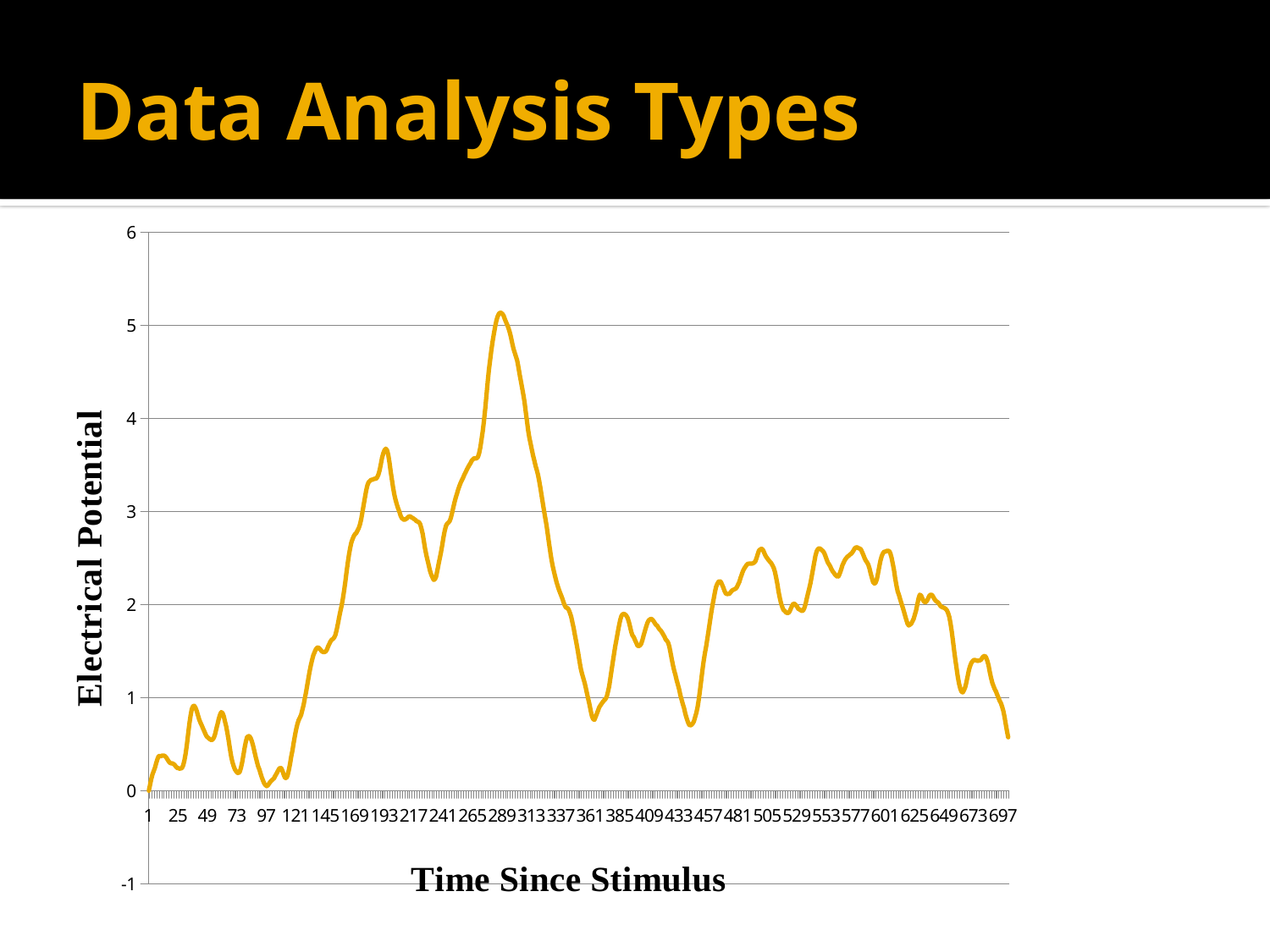
Is the value of the line at x = 193 greater or less than 3? greater Is the value of the line at x = 289 greater or less than 4? greater What is the title of the horizontal axis of the chart? Time Since Stimulus Near which x-axis tick label does the line reach its highest value? 289 Is the value of the line at x = 1 greater or less than 1? less Does the line generally rise or fall between x = 289 and x = 361? fall Does the line generally rise or fall between x = 121 and x = 193? rise What kind of chart is shown on the slide? line chart What is the title of the vertical axis of the chart? Electrical Potential